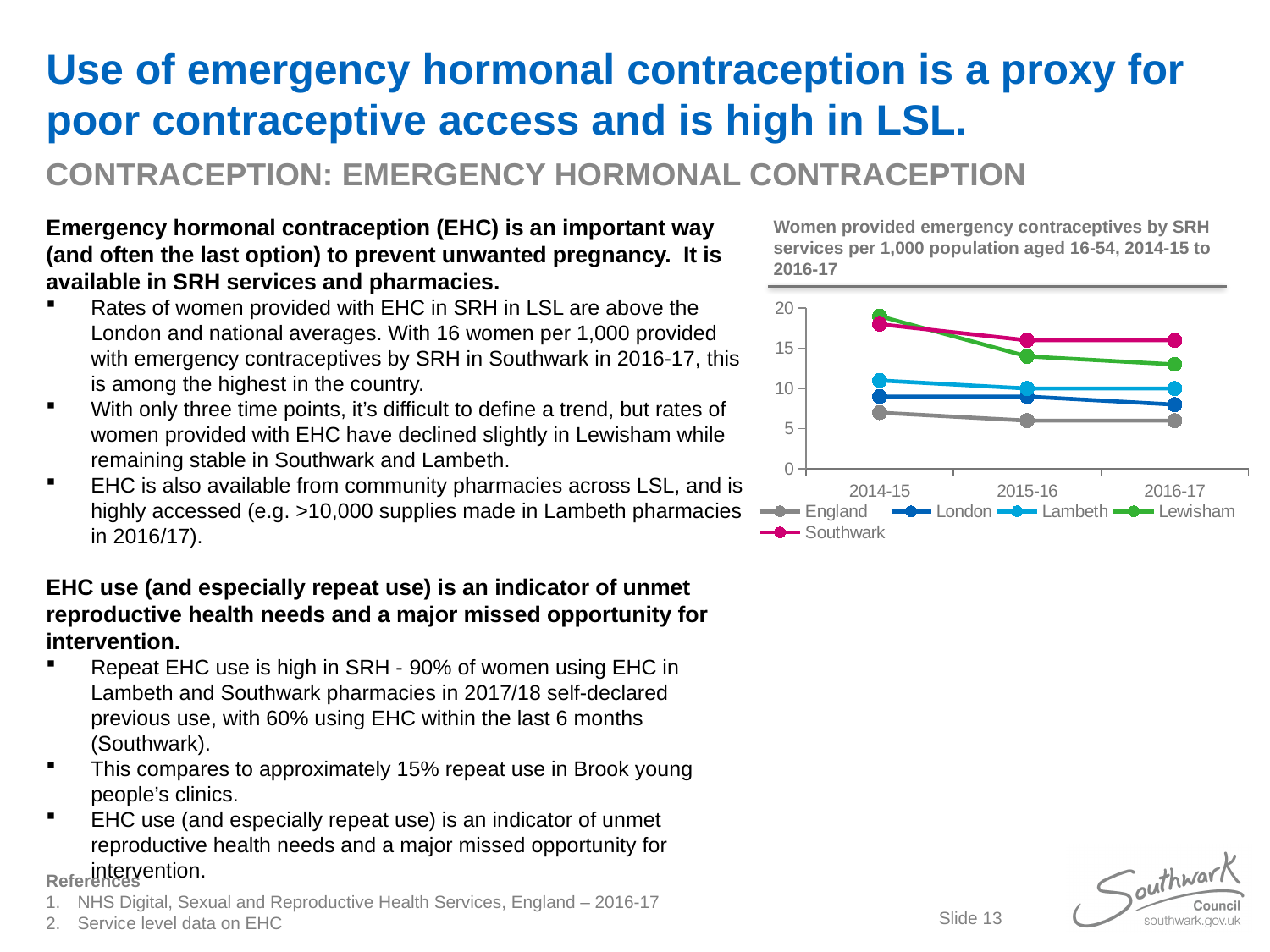
Is the value for Southwark in 2016-17 greater or less than 10? greater Is the value for Lewisham in 2014-15 greater or less than 15? greater Is the value for England in 2016-17 greater or less than 10? less In 2015-16, which is larger: the value for Lewisham or the value for Lambeth? Lewisham How many time points are plotted on the x axis of the chart? 3 What is the title of the chart? Women provided emergency contraceptives by SRH services per 1,000 population aged 16-54, 2014-15 to 2016-17 How many series does the chart legend list? 5 Which series has the highest value in 2016-17? Southwark Does the value for Lewisham rise or fall from 2014-15 to 2016-17? Fall What type of chart is shown on the slide? Line chart Which series has the lowest value in 2014-15? England